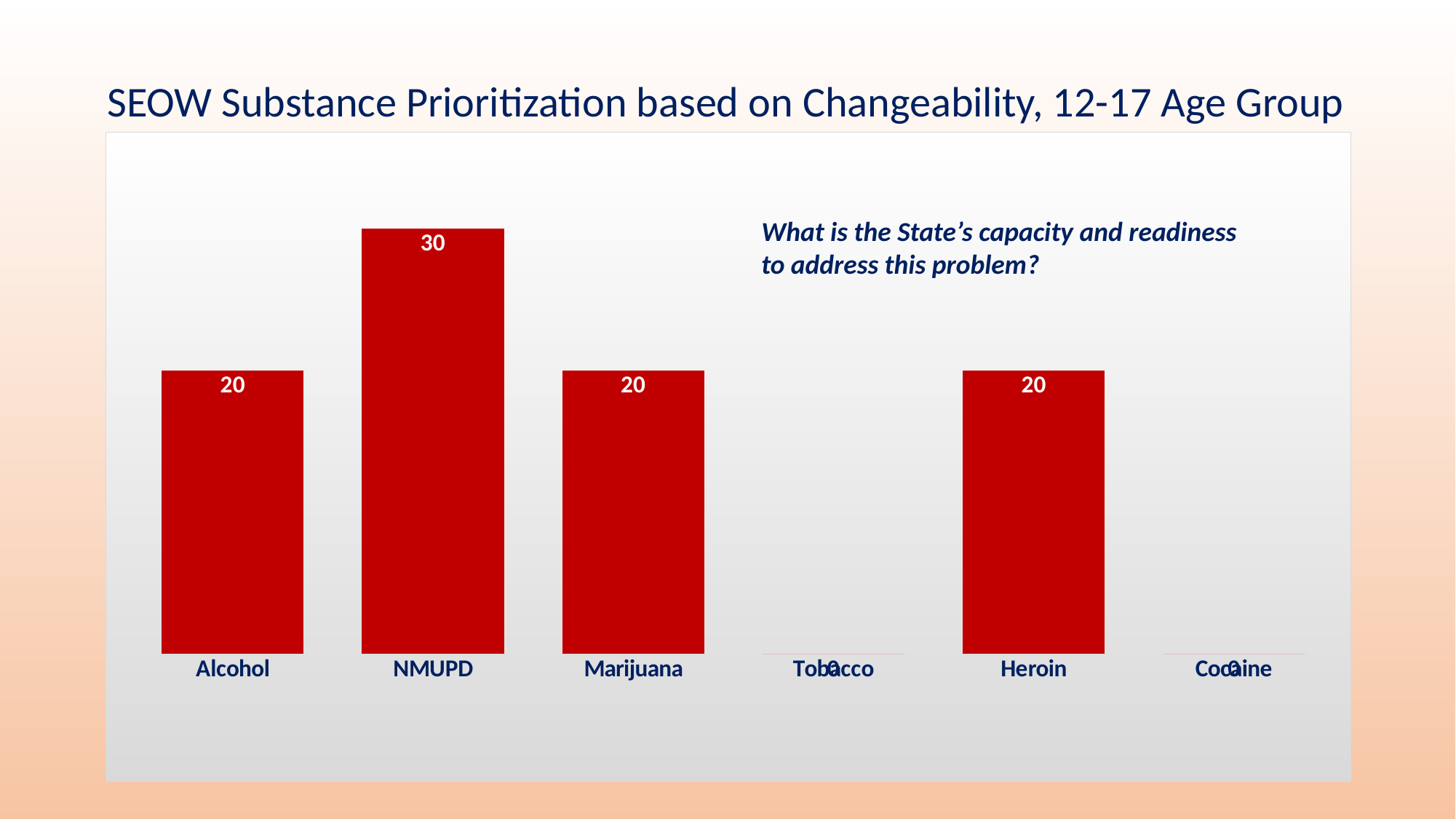
What is the value for NMUPD? 30 What is the value for Alcohol? 20 What is the difference between the values for NMUPD and Marijuana? 10 What is the value for Heroin? 20 What is the value for Tobacco? 0 Which substance has the highest value? NMUPD What is the difference between the values for Heroin and Cocaine? 20 What kind of chart is shown on the slide? Bar chart Which is larger, the value for NMUPD or the value for Alcohol? NMUPD What is the value for Cocaine? 0 How many substance categories are shown on the x axis? 6 Which is larger, the value for Marijuana or the value for Tobacco? Marijuana